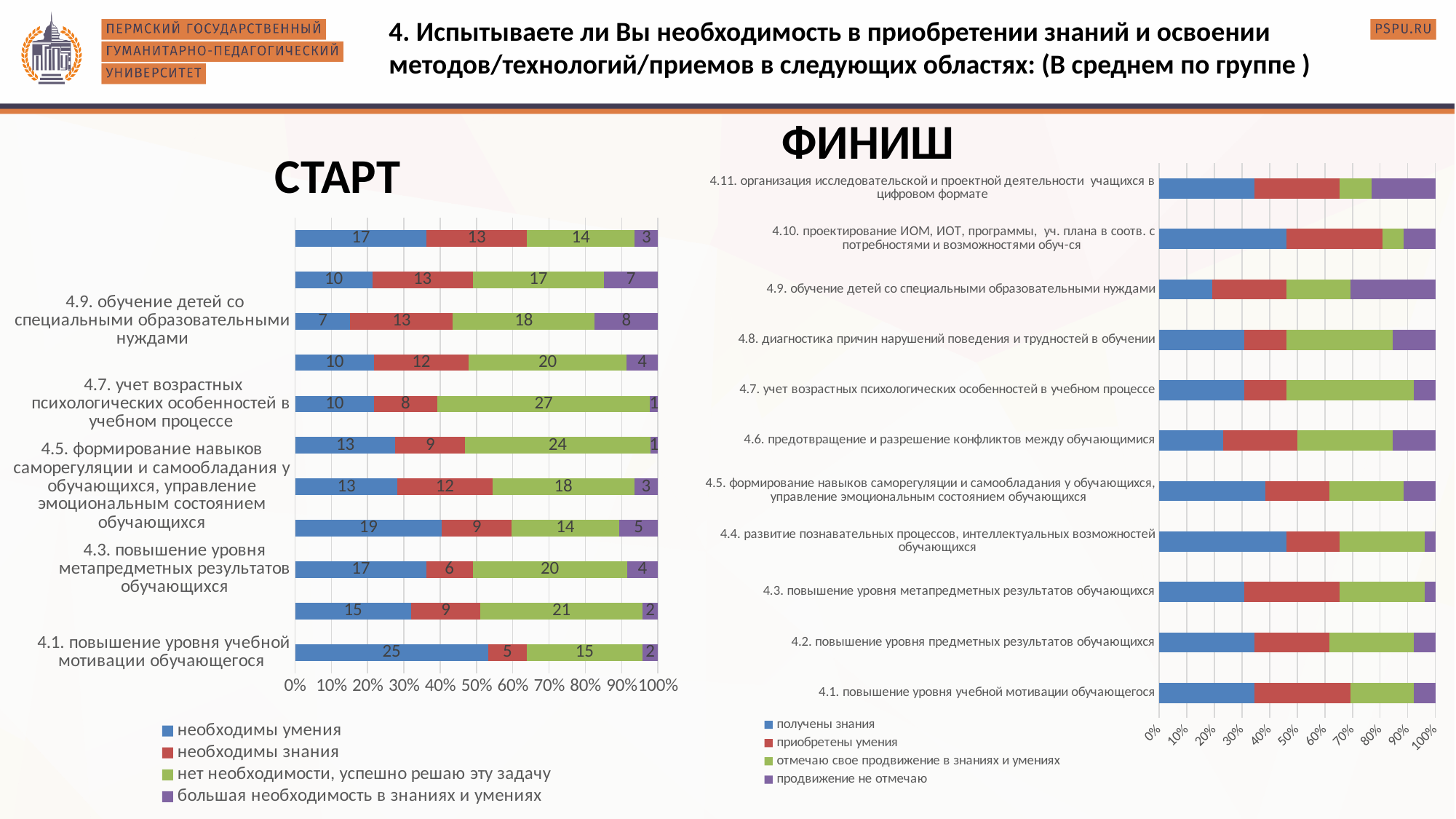
In the СТАРТ chart, what is the total of all segments in the bar for '4.3. повышение уровня метапредметных результатов обучающихся'? 47 In the СТАРТ chart, what is the value of 'нет необходимости, успешно решаю эту задачу' for '4.7. учет возрастных психологических особенностей в учебном процессе'? 27 What kind of chart is the СТАРТ chart on the left? bar chart In the СТАРТ chart, what is the value of 'необходимы умения' for '4.1. повышение уровня учебной мотивации обучающегося'? 25 In the СТАРТ chart, what is the value of 'большая необходимость в знаниях и умениях' for '4.5. формирование навыков саморегуляции и самообладания у обучающихся'? 3 What is the title of the chart on the right side of the slide? ФИНИШ In the СТАРТ chart, what is the difference between 'необходимы умения' and 'необходимы знания' for '4.1. повышение уровня учебной мотивации обучающегося'? 20 How many categories are shown in the ФИНИШ chart? 11 In the СТАРТ chart, for '4.9. обучение детей со специальными образовательными нуждами', which is larger: 'необходимы умения' or 'необходимы знания'? необходимы знания In the СТАРТ chart, which category has the highest value for 'необходимы умения'? 4.1. повышение уровня учебной мотивации обучающегося How many series does the legend of the ФИНИШ chart list? 4 In the ФИНИШ chart, is the value of 'получены знания' for '4.1. повышение уровня учебной мотивации обучающегося' greater or less than 30%? greater